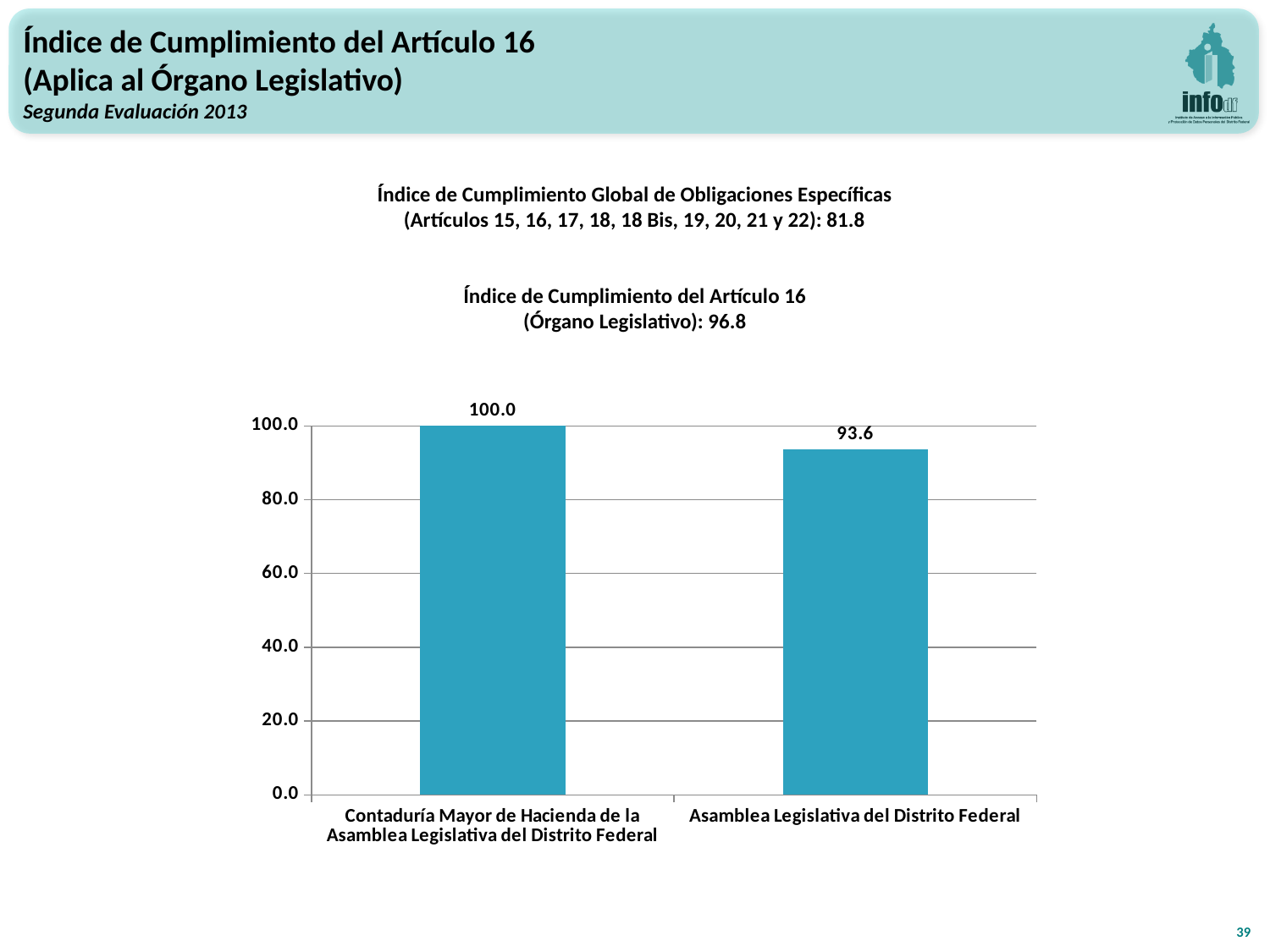
Do the values rise or fall from left to right along the x axis? fall What is the highest value shown on the y axis? 100.0 Which category has the highest value? Contaduría Mayor de Hacienda de la Asamblea Legislativa del Distrito Federal What kind of chart is shown on the slide? bar chart What is the difference between the values for Contaduría Mayor de Hacienda de la Asamblea Legislativa del Distrito Federal and Asamblea Legislativa del Distrito Federal? 6.4 How many categories are shown in the chart? 2 Is the value for Asamblea Legislativa del Distrito Federal greater or less than 80.0? greater Which is larger, the value for Contaduría Mayor de Hacienda de la Asamblea Legislativa del Distrito Federal or the value for Asamblea Legislativa del Distrito Federal? Contaduría Mayor de Hacienda de la Asamblea Legislativa del Distrito Federal What is the value for Asamblea Legislativa del Distrito Federal? 93.6 What colour are the bars in the chart? blue What is the value for Contaduría Mayor de Hacienda de la Asamblea Legislativa del Distrito Federal? 100.0 Which category has the lowest value? Asamblea Legislativa del Distrito Federal